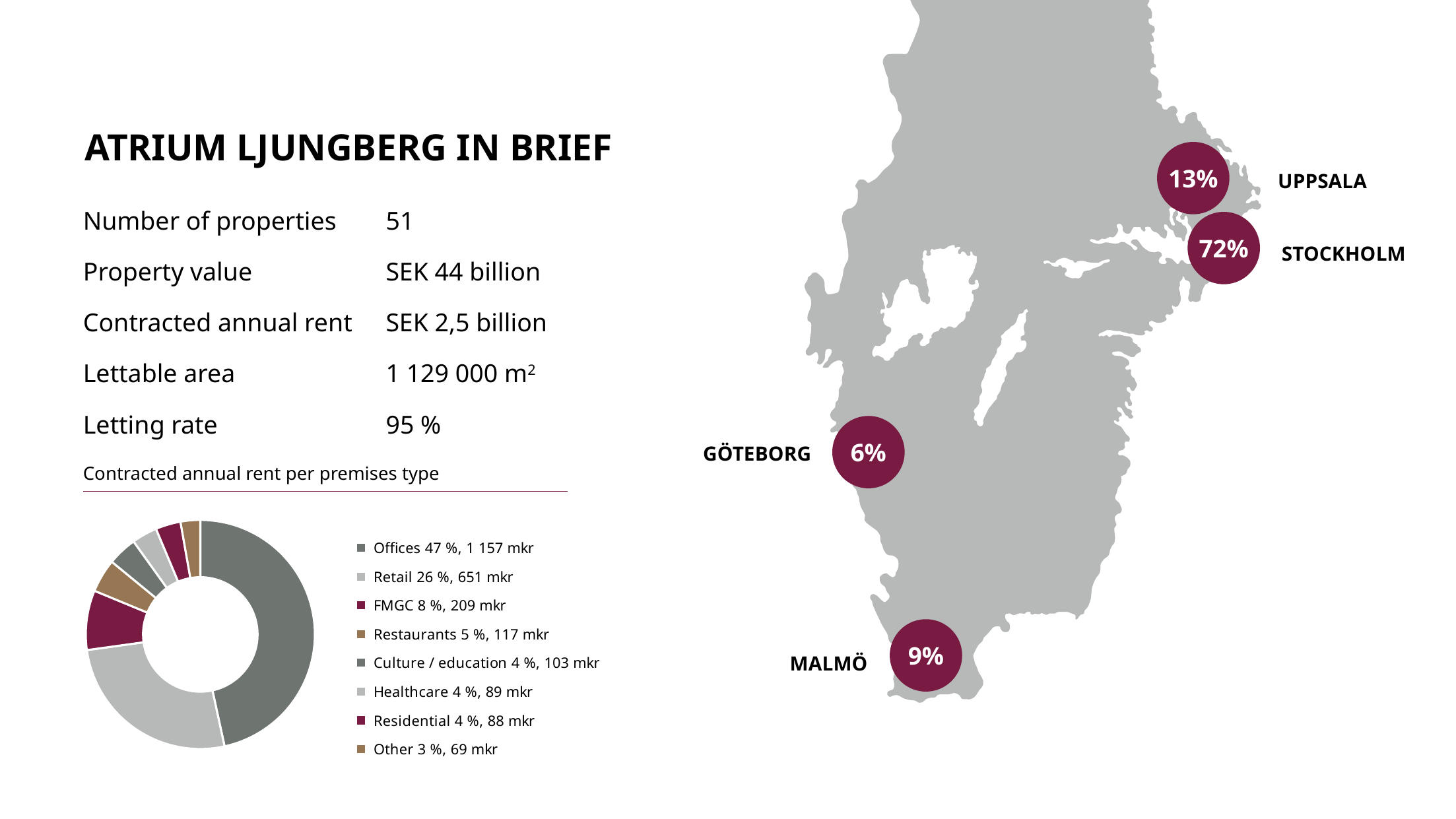
In the "Contracted annual rent per premises type" chart, what is the contracted annual rent for Offices? 1 157 mkr In the "Contracted annual rent per premises type" chart, which premises type has the lowest contracted annual rent? Other How many premises types are listed in the legend of the "Contracted annual rent per premises type" chart? 8 What kind of chart is shown under "Contracted annual rent per premises type"? pie chart (donut) In the "Contracted annual rent per premises type" chart, what is the contracted annual rent for Healthcare? 89 mkr In the "Contracted annual rent per premises type" chart, which premises type has the highest contracted annual rent? Offices In the "Contracted annual rent per premises type" chart, how much larger is the contracted annual rent for Offices than for Retail, in mkr? 506 mkr In the "Contracted annual rent per premises type" chart, which has the larger contracted annual rent, FMGC or Restaurants? FMGC In the "Contracted annual rent per premises type" chart, what share of contracted annual rent comes from Residential? 4 % On the map on the right of the slide, what percentage is shown for Stockholm? 72% In the "Contracted annual rent per premises type" chart, what is the difference in contracted annual rent between Retail and FMGC, in mkr? 442 mkr In the "Contracted annual rent per premises type" chart, what share of contracted annual rent comes from Retail? 26 %